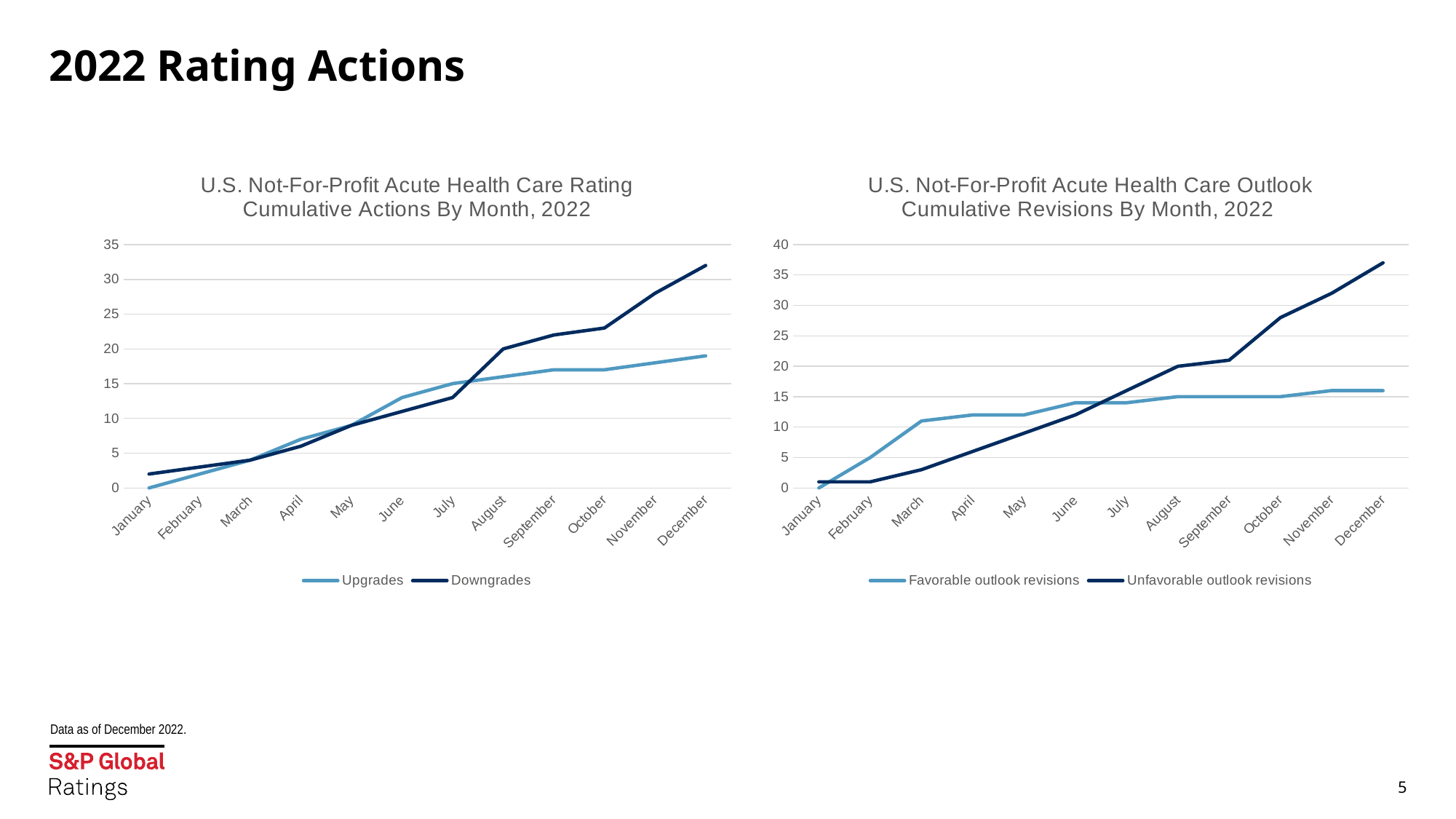
In the right chart, 'Outlook Cumulative Revisions By Month, 2022', which series has the larger value in March, Favorable outlook revisions or Unfavorable outlook revisions? Favorable outlook revisions In the right chart, 'Outlook Cumulative Revisions By Month, 2022', is the Favorable outlook revisions value for December greater or less than 20? less How many months are plotted along the x axis of the left chart, 'Rating Cumulative Actions By Month, 2022'? 12 In the left chart, 'Rating Cumulative Actions By Month, 2022', is the Downgrades value for December greater or less than 30? greater What kind of chart is the left chart, 'U.S. Not-For-Profit Acute Health Care Rating Cumulative Actions By Month, 2022'? Line chart In the right chart, 'Outlook Cumulative Revisions By Month, 2022', in which month does the Unfavorable outlook revisions series reach its highest value? December In the left chart, 'Rating Cumulative Actions By Month, 2022', which series has the larger value in December, Upgrades or Downgrades? Downgrades In the right chart, 'Outlook Cumulative Revisions By Month, 2022', is the Unfavorable outlook revisions value for December greater or less than 35? greater How many series does the legend of the right chart, 'U.S. Not-For-Profit Acute Health Care Outlook Cumulative Revisions By Month, 2022', list? 2 What are the two legend entries of the left chart, 'Rating Cumulative Actions By Month, 2022'? Upgrades and Downgrades In the left chart, 'Rating Cumulative Actions By Month, 2022', does the Downgrades line rise or fall from January to December? Rise